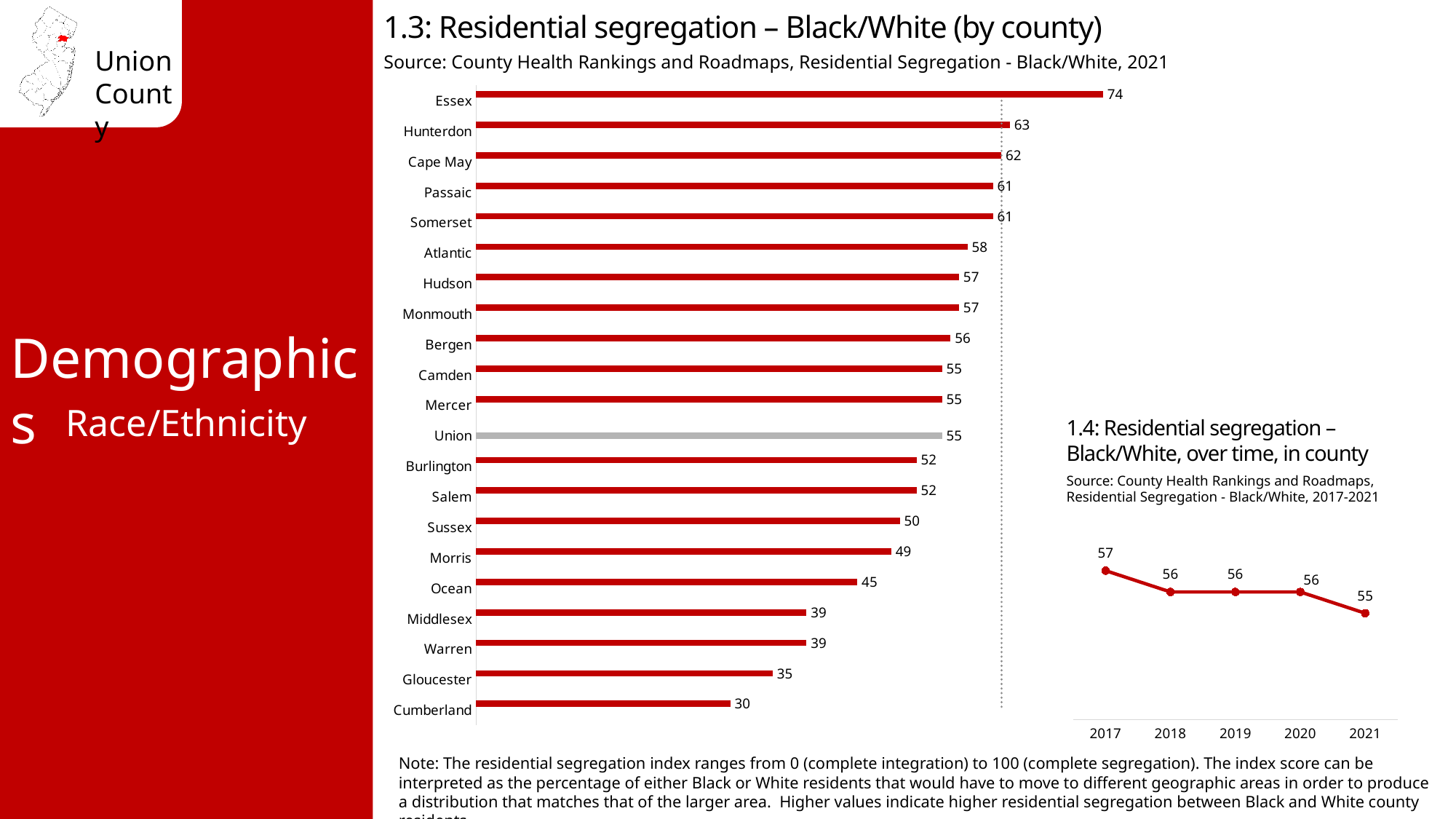
In chart 1.3 (Residential segregation – Black/White by county), what is the value for Union? 55 In chart 1.4 (over time, in county), what is the value for 2021? 55 In chart 1.3 (by county), what is the value for Essex? 74 In chart 1.4 (over time, in county), do the values rise or fall from 2017 to 2021? Fall In chart 1.3 (by county), what is the difference between Essex and Cumberland? 44 In chart 1.4 (over time, in county), what is the value for 2017? 57 In chart 1.3 (by county), which county has the lowest value? Cumberland In chart 1.3 (by county), which is larger, the value for Morris or the value for Ocean? Morris In chart 1.3 (by county), how many counties are shown? 21 In chart 1.3 (by county), which bar is coloured grey instead of red? Union In chart 1.3 (by county), which county has the highest value? Essex What kind of chart is chart 1.3 (by county)? Bar chart